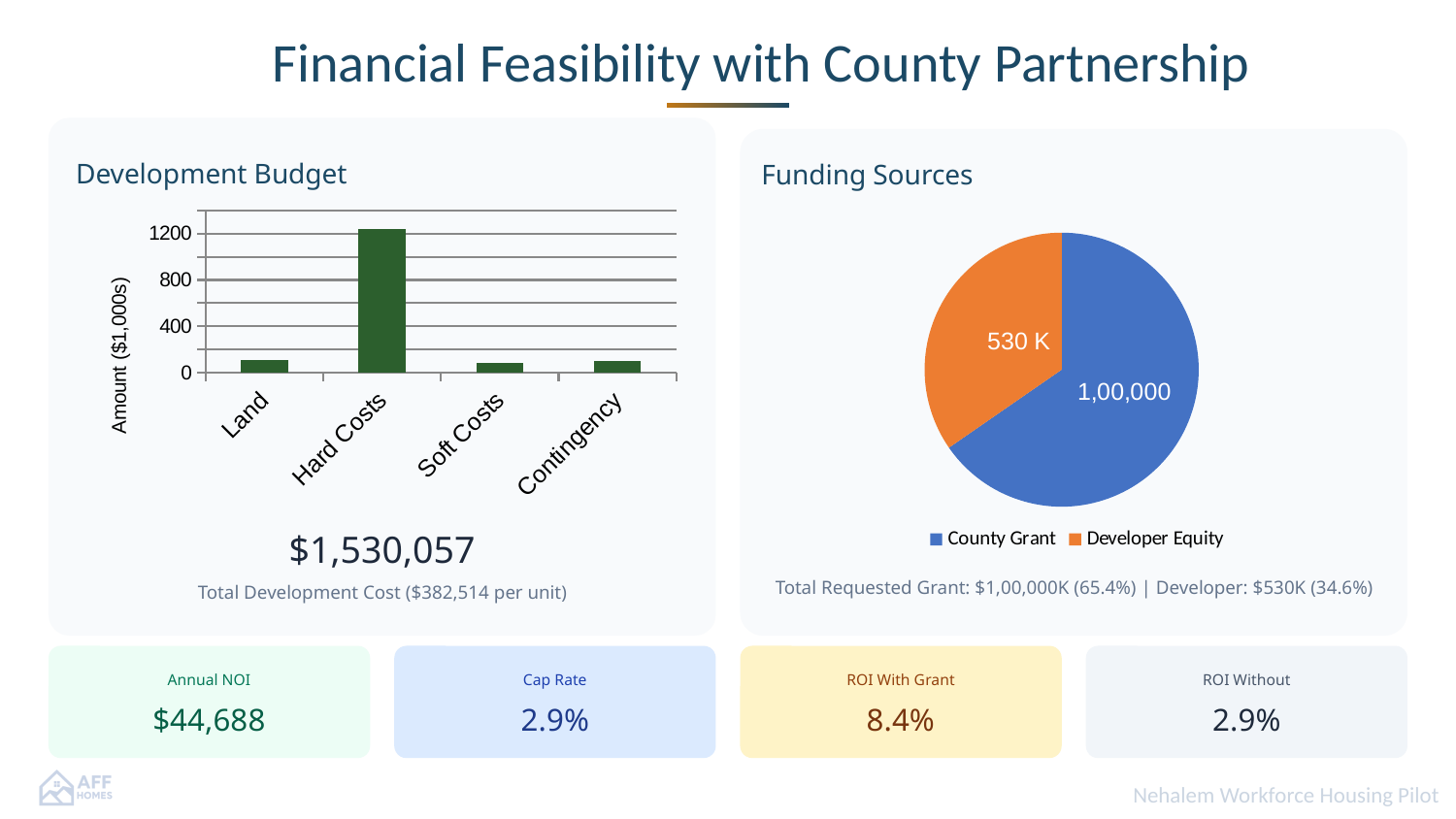
How many entries does the legend of the Funding Sources chart list? 2 What kind of chart is the Funding Sources chart? pie chart How many categories are shown in the Development Budget chart? 4 What kind of chart is the Development Budget chart? bar chart In the Development Budget chart, is the value for Land greater or less than 400? less In the Development Budget chart, is the value for Hard Costs greater or less than 800? greater In the Funding Sources chart, what is the value shown for Developer Equity? 530 K What is the label on the vertical axis of the Development Budget chart? Amount ($1,000s) In the Funding Sources chart, which slice is larger, County Grant or Developer Equity? County Grant In the Development Budget chart, which category has the highest value? Hard Costs In the Funding Sources chart, what is the value shown for County Grant? 1,00,000 In the Development Budget chart, which is larger, Hard Costs or Contingency? Hard Costs